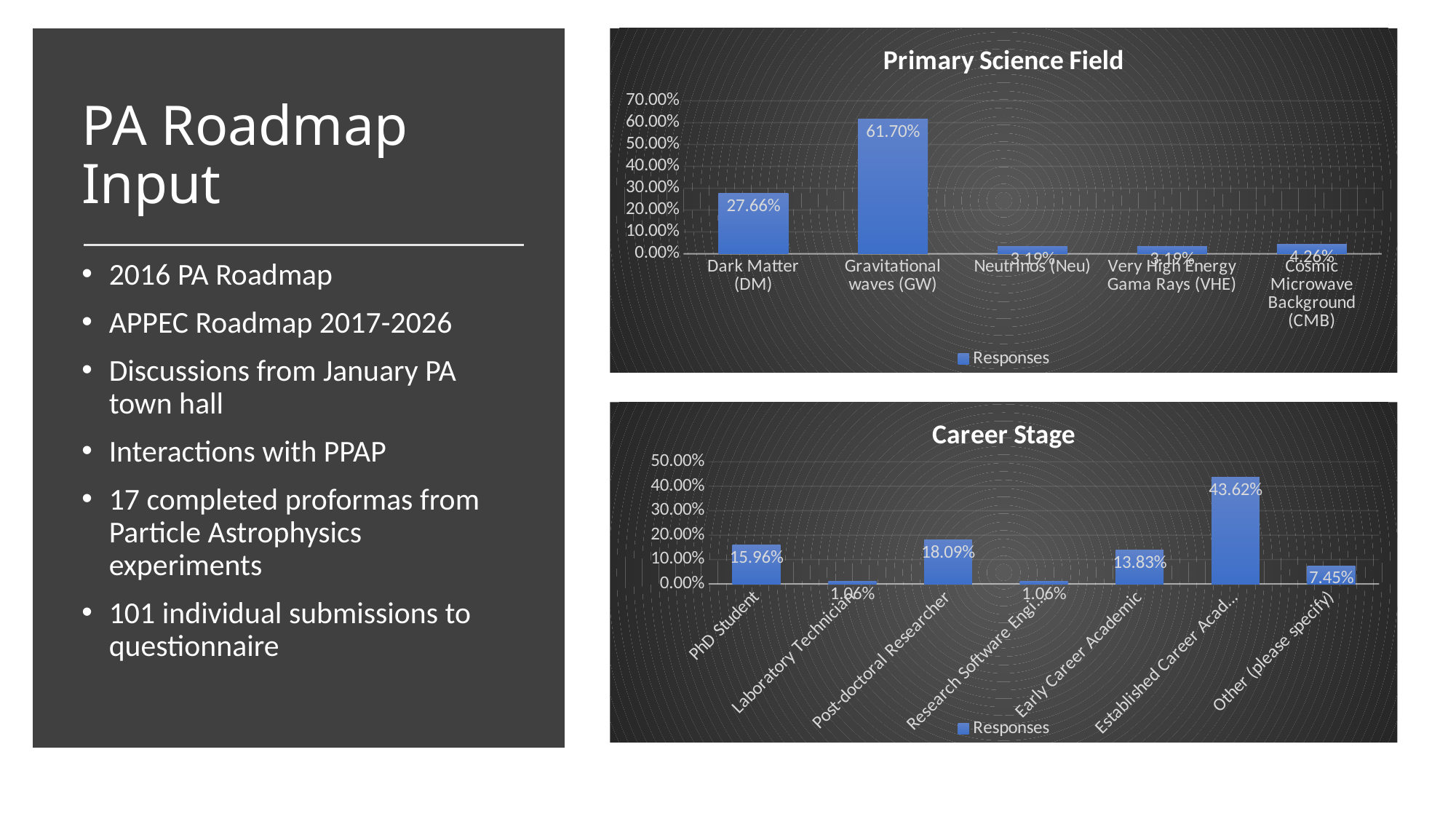
In the Career Stage chart, what is the value for Established Career Acad...? 43.62% In the Career Stage chart, how many categories are shown? 7 In the Primary Science Field chart, what is the value for Cosmic Microwave Background (CMB)? 4.26% In the Primary Science Field chart, what is the difference between Gravitational waves (GW) and Dark Matter (DM)? 34.04% In the Career Stage chart, what is the value for Post-doctoral Researcher? 18.09% In the Career Stage chart, which is larger, PhD Student or Early Career Academic? PhD Student In the Primary Science Field chart, what is the value for Gravitational waves (GW)? 61.70% In the Primary Science Field chart, what is the value for Dark Matter (DM)? 27.66% In the Career Stage chart, what is the difference between Post-doctoral Researcher and Other (please specify)? 10.64% In the Primary Science Field chart, which category has the highest value? Gravitational waves (GW) In the Primary Science Field chart, how many categories are shown? 5 What type of chart is the Career Stage chart? Bar chart